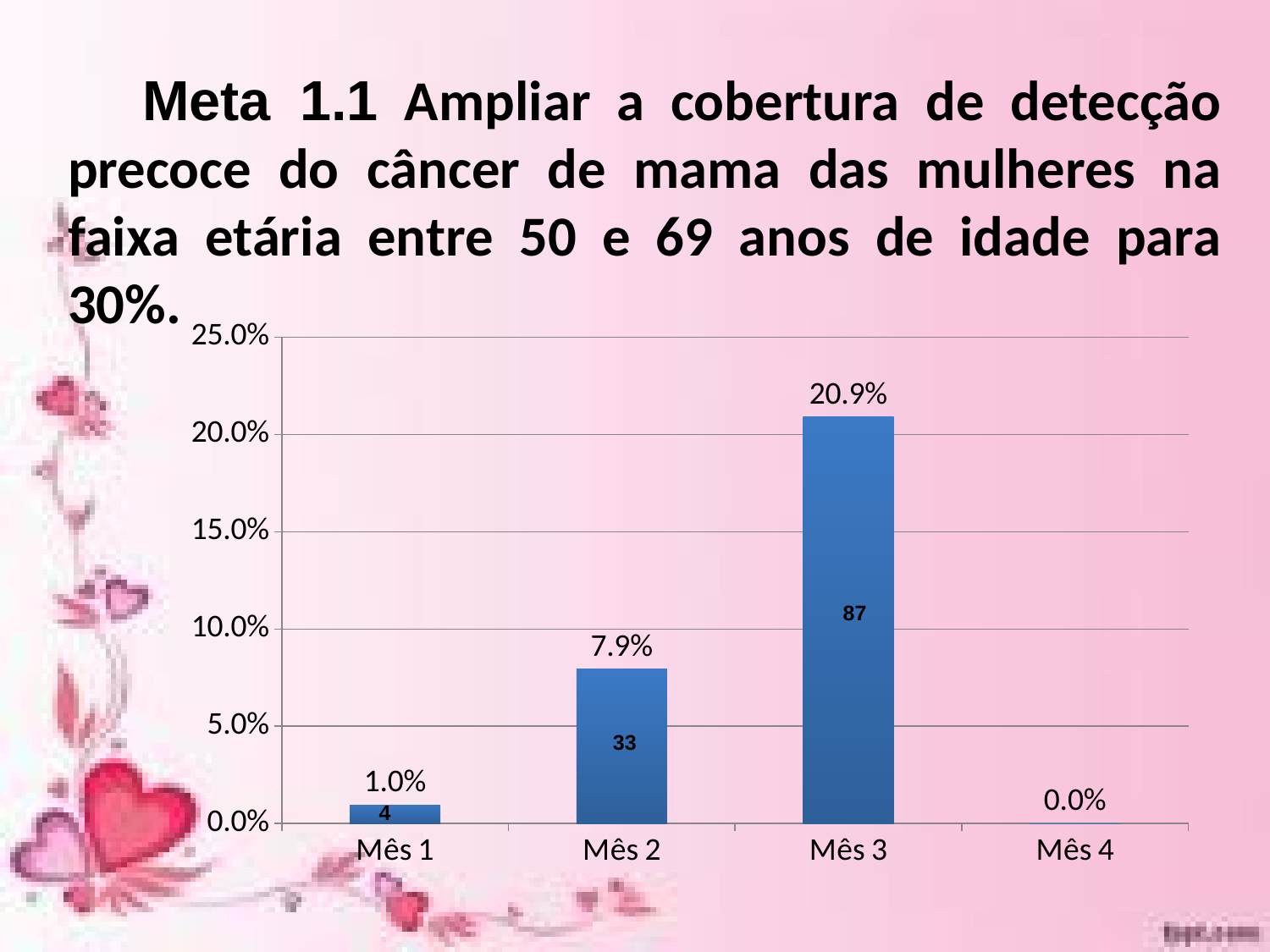
What is the percentage value shown for Mês 1? 1.0% What count is printed inside the bar for Mês 3? 87 How many months are shown on the x axis? 4 Which is larger, the percentage for Mês 2 or for Mês 1? Mês 2 Which month has the lowest percentage? Mês 4 What is the difference in percentage between Mês 3 and Mês 2? 13.0% What kind of chart is shown on the slide? Bar chart What is the percentage value shown for Mês 3? 20.9% What is the percentage value shown for Mês 4? 0.0% What is the percentage value shown for Mês 2? 7.9% What count is printed inside the bar for Mês 2? 33 Which month has the highest percentage? Mês 3